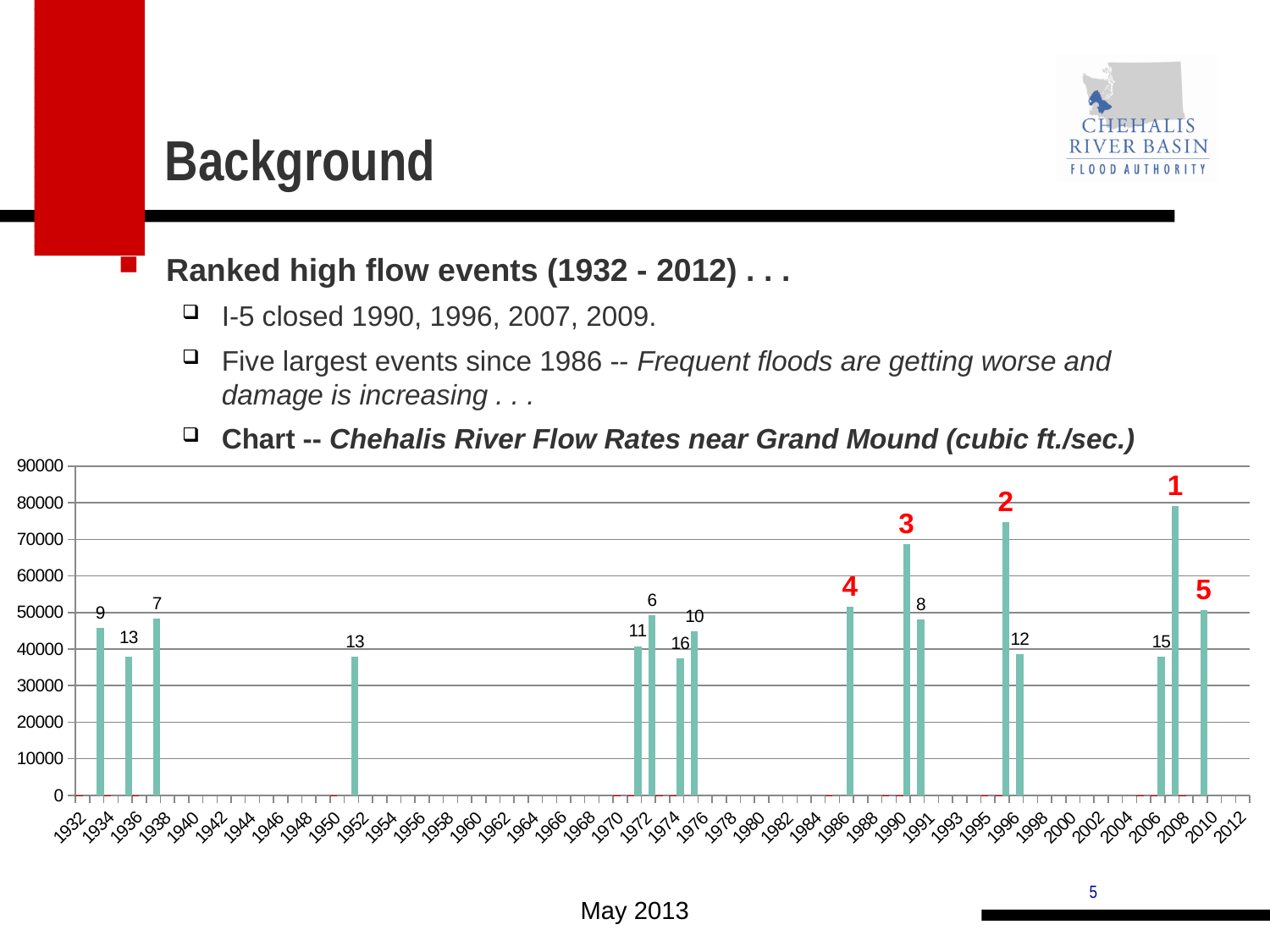
Is the value of the bar labeled 9 greater or less than 50000? less How many bars in the chart carry a rank label? 16 Which is larger, the bar labeled 5 or the bar labeled 1? the bar labeled 1 Is the value of the bar labeled 3 greater or less than 60000? greater Is the value of the bar labeled 2 greater or less than 70000? greater Which is larger, the bar labeled 2 or the bar labeled 3? the bar labeled 2 What is the highest value shown on the vertical axis of the chart? 90000 Which bar is the tallest in the chart? the bar labeled 1 What kind of chart is shown on the slide? bar chart What is the title of the chart according to the slide text? Chehalis River Flow Rates near Grand Mound (cubic ft./sec.)